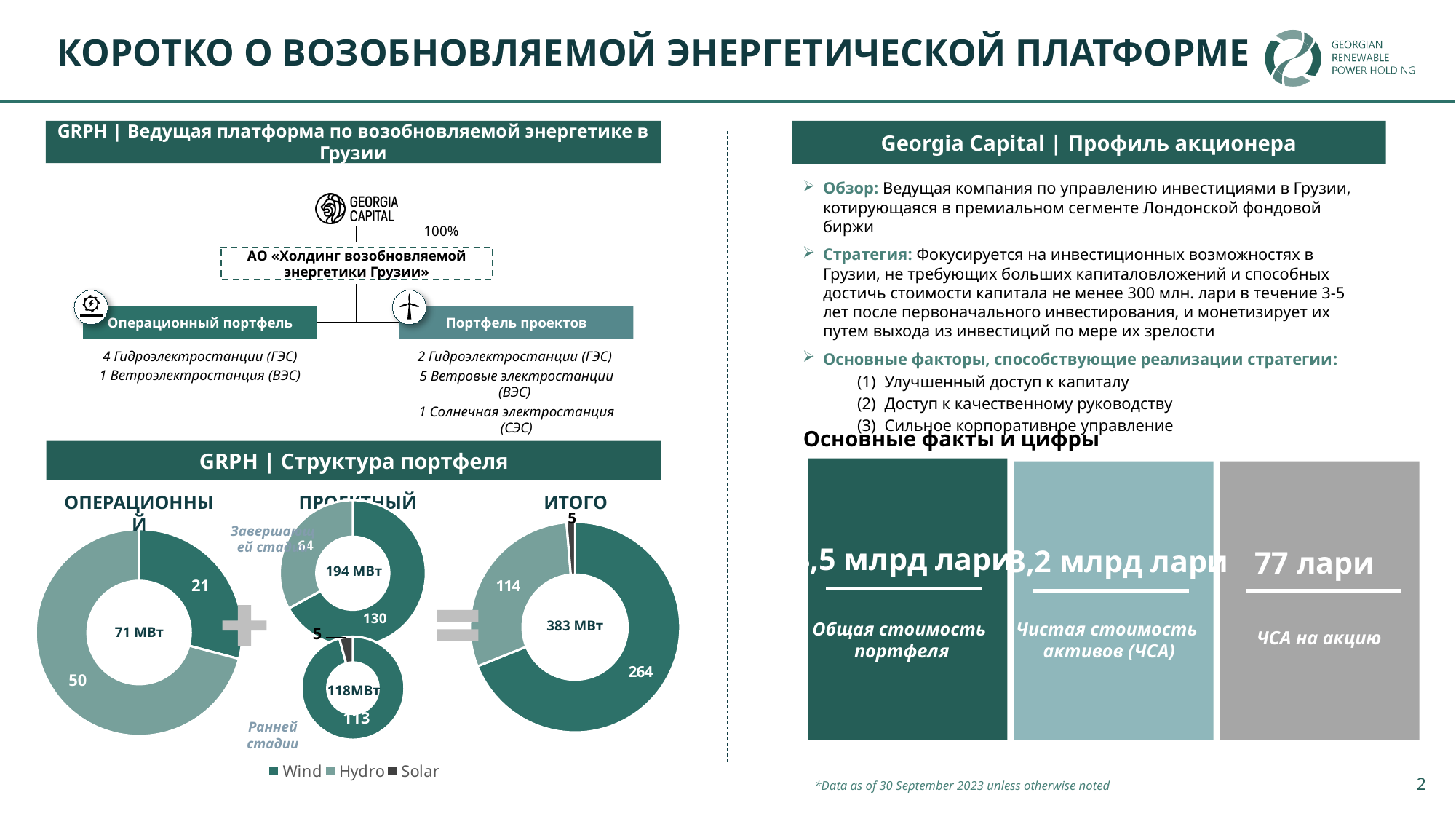
What kind of chart is used in the 'GRPH | Структура портфеля' section to show the portfolio breakdown? Donut (pie) chart In the 'Ранней стадии' donut chart in the 'ПРОЕКТНЫЙ' section, what is the value for Solar? 5 In the 'ИТОГО' donut chart, what is the difference between the Wind value and the Hydro value? 150 What total capacity is shown in the centre of the 'ИТОГО' donut chart? 383 МВт In the 'ИТОГО' donut chart, what is the value for Wind? 264 In the 'ОПЕРАЦИОННЫЙ' donut chart, what is the value for Hydro? 50 In the 'ОПЕРАЦИОННЫЙ' donut chart, what is the value for Wind? 21 In the 'ОПЕРАЦИОННЫЙ' donut chart, which is larger, Hydro or Wind? Hydro In the 'ИТОГО' donut chart, which series has the smallest value? Solar How many series does the legend under the 'GRPH | Структура портфеля' charts list? 3 In the 'ИТОГО' donut chart, which series has the largest value? Wind What capacity is shown in the centre of the 'Завершающей стадии' donut chart in the 'ПРОЕКТНЫЙ' section? 194 МВт